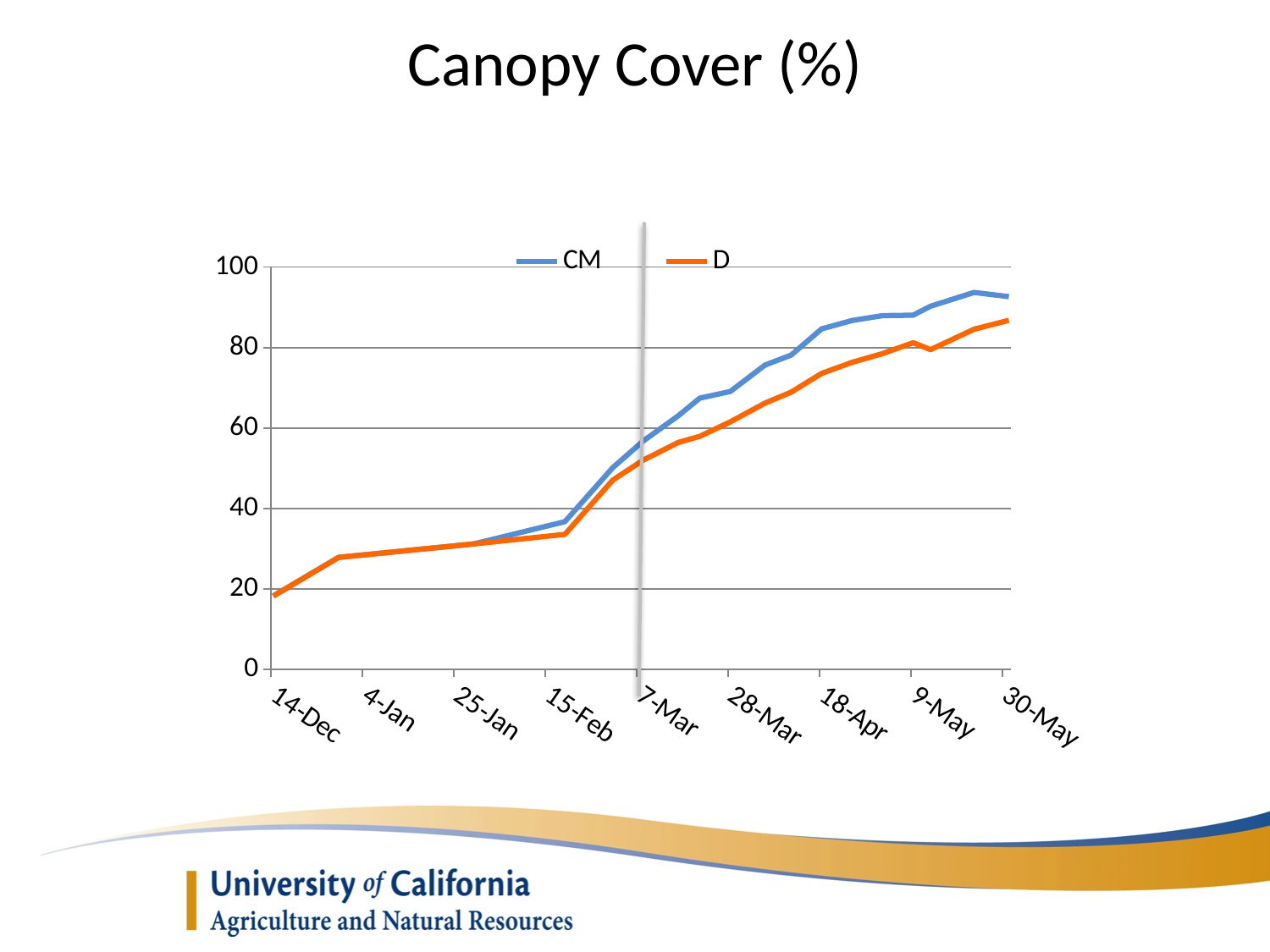
What is the title of the chart? Canopy Cover (%) Is the value for D at 18-Apr greater or less than 80? less What are the names of the two series in the legend? CM and D Is the value for D at 14-Dec greater or less than 20? less How many series does the legend list? 2 Is the value for D at 7-Mar greater or less than 60? less How many date labels are shown on the x axis? 9 At 30-May, which series has the higher value, CM or D? CM Do the values for the CM series rise or fall from 14-Dec to 30-May? rise Do the values for the D series rise or fall along the x axis overall? rise What kind of chart is shown on the slide? line chart